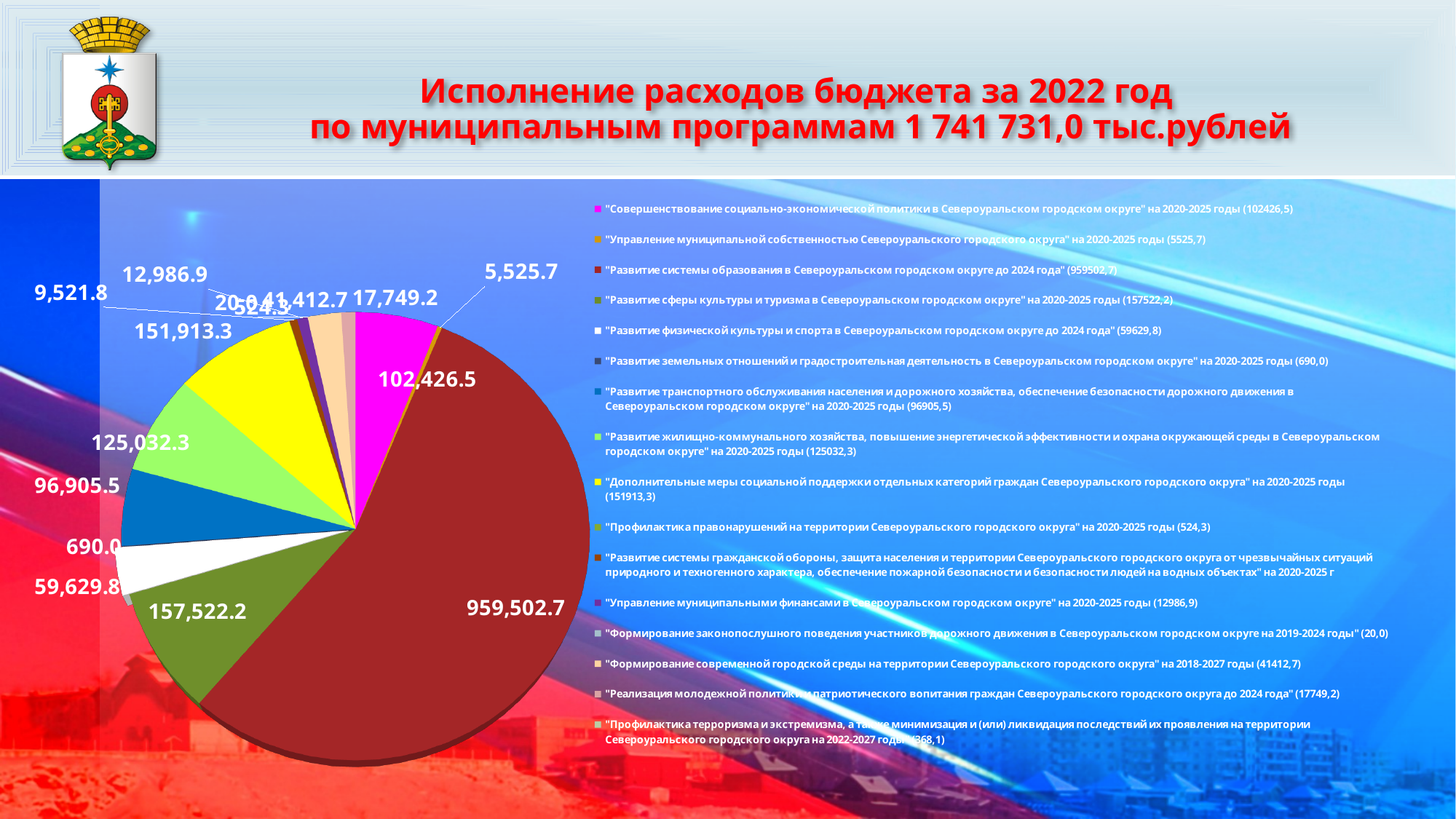
What value is labelled for "Развитие жилищно-коммунального хозяйства" on the pie chart? 125,032.3 What total amount of budget expenditure on municipal programs is stated in the slide title? 1 741 731,0 тыс.рублей Which is larger: the value for "Развитие физической культуры и спорта" or the value for "Развитие транспортного обслуживания"? "Развитие транспортного обслуживания" (96,905.5) How many programs are listed in the legend of the pie chart? 16 What is the smallest value labelled on the pie chart? 20.0 What value is labelled for "Развитие транспортного обслуживания населения и дорожного хозяйства" on the pie chart? 96,905.5 What kind of chart is shown on the slide? pie chart What value is labelled on the magenta slice for "Совершенствование социально-экономической политики"? 102,426.5 What is the difference between the values for "Развитие сферы культуры и туризма" (157,522.2) and "Дополнительные меры социальной поддержки" (151,913.3)? 5,608.9 What is the value shown for the largest slice of the pie chart? 959,502.7 What value is labelled on the green slice for "Развитие сферы культуры и туризма"? 157,522.2 Which program has the largest slice of the pie chart? "Развитие системы образования в Североуральском городском округе до 2024 года"